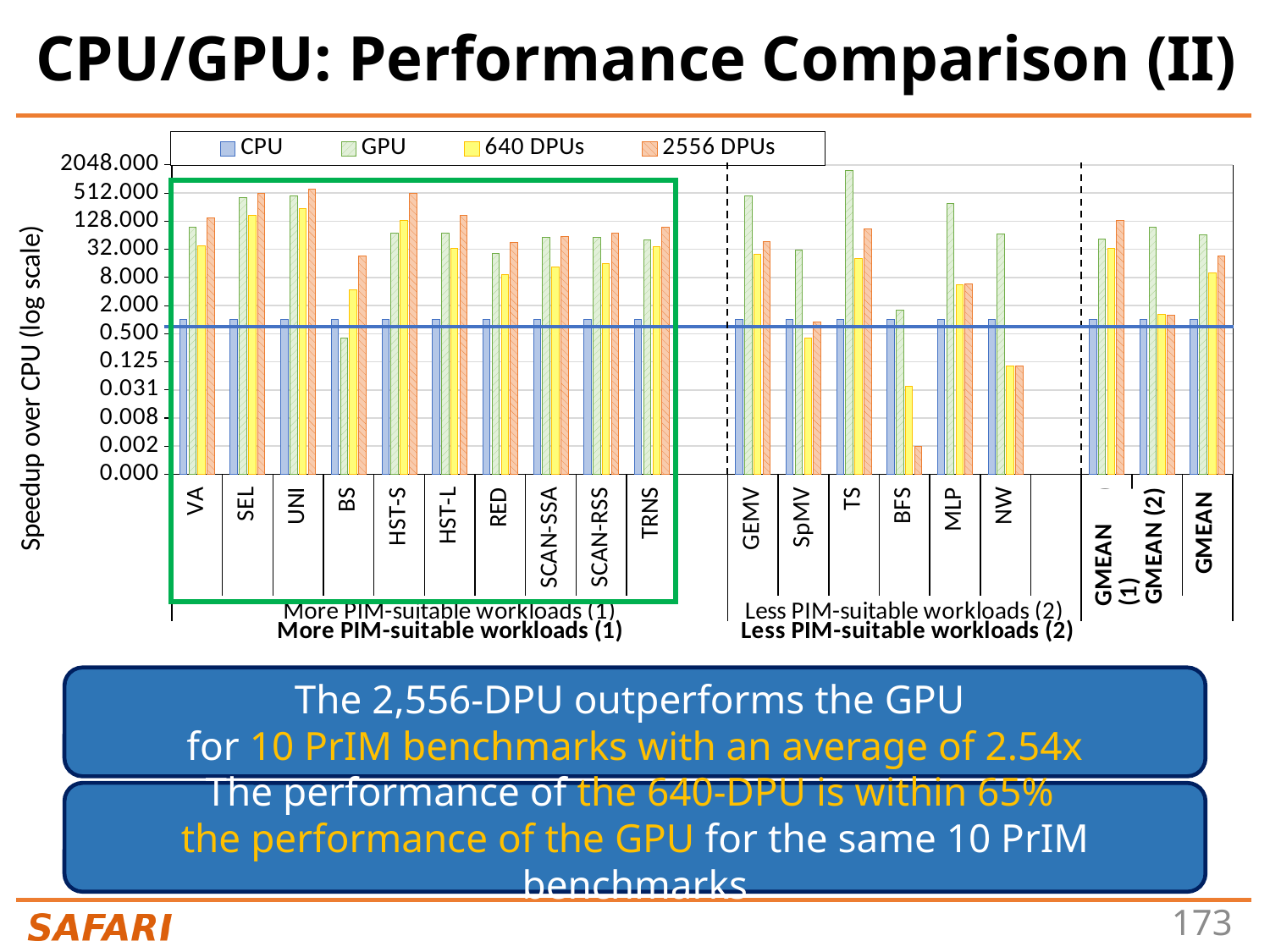
How many workloads are in the 'Less PIM-suitable workloads (2)' group? 6 How many series does the chart legend list? 4 Is the 2556 DPUs value for BFS greater or less than 0.008? less How many workloads are in the 'More PIM-suitable workloads (1)' group? 10 For GEMV, which is larger: the GPU bar or the 2556 DPUs bar? GPU What kind of chart is shown on the slide? bar chart Which series are listed in the chart legend? CPU, GPU, 640 DPUs, 2556 DPUs For BS, which is larger: the GPU bar or the 2556 DPUs bar? 2556 DPUs Which workload has the lowest 2556 DPUs speedup bar? BFS What is the label of the vertical axis of the chart? Speedup over CPU (log scale) Is the GPU value for TS greater or less than 512.000? greater Which workload has the highest GPU speedup bar? TS